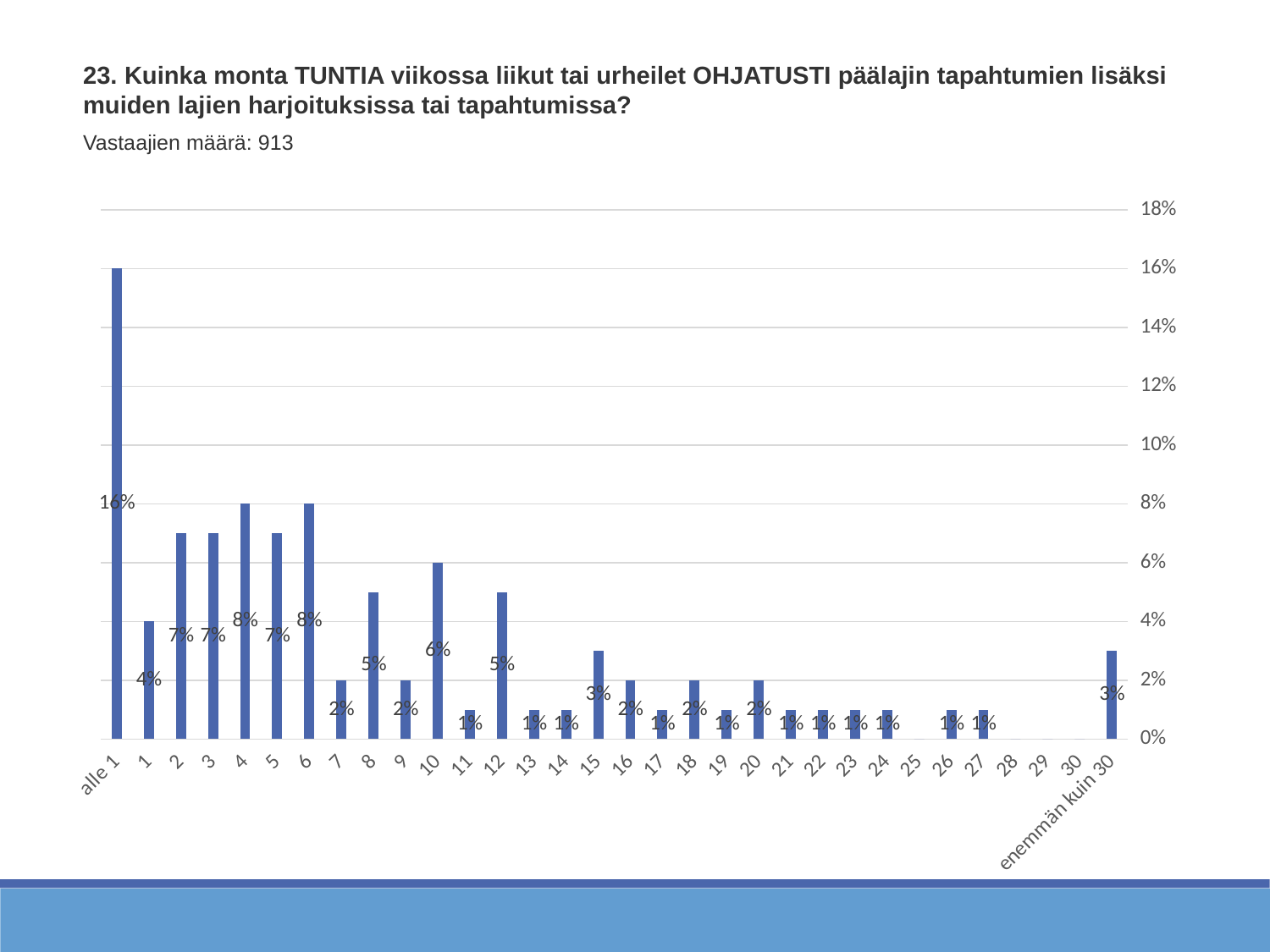
What is the difference between the values for "alle 1" and "1"? 12 percentage points Which category has the highest value? alle 1 What is the value for the category "alle 1"? 16% What kind of chart is shown on the slide? bar chart What is the value for the category "enemmän kuin 30"? 3% What is the value for the category "15"? 3% What is the difference between the values for "10" and "12"? 1 percentage point How many categories are shown on the x axis? 32 Which has the larger value, category "4" or category "8"? 4 What is the highest value shown on the vertical axis? 18% Is the value for "alle 1" greater or less than 14%? greater What is the value for the category "10"? 6%